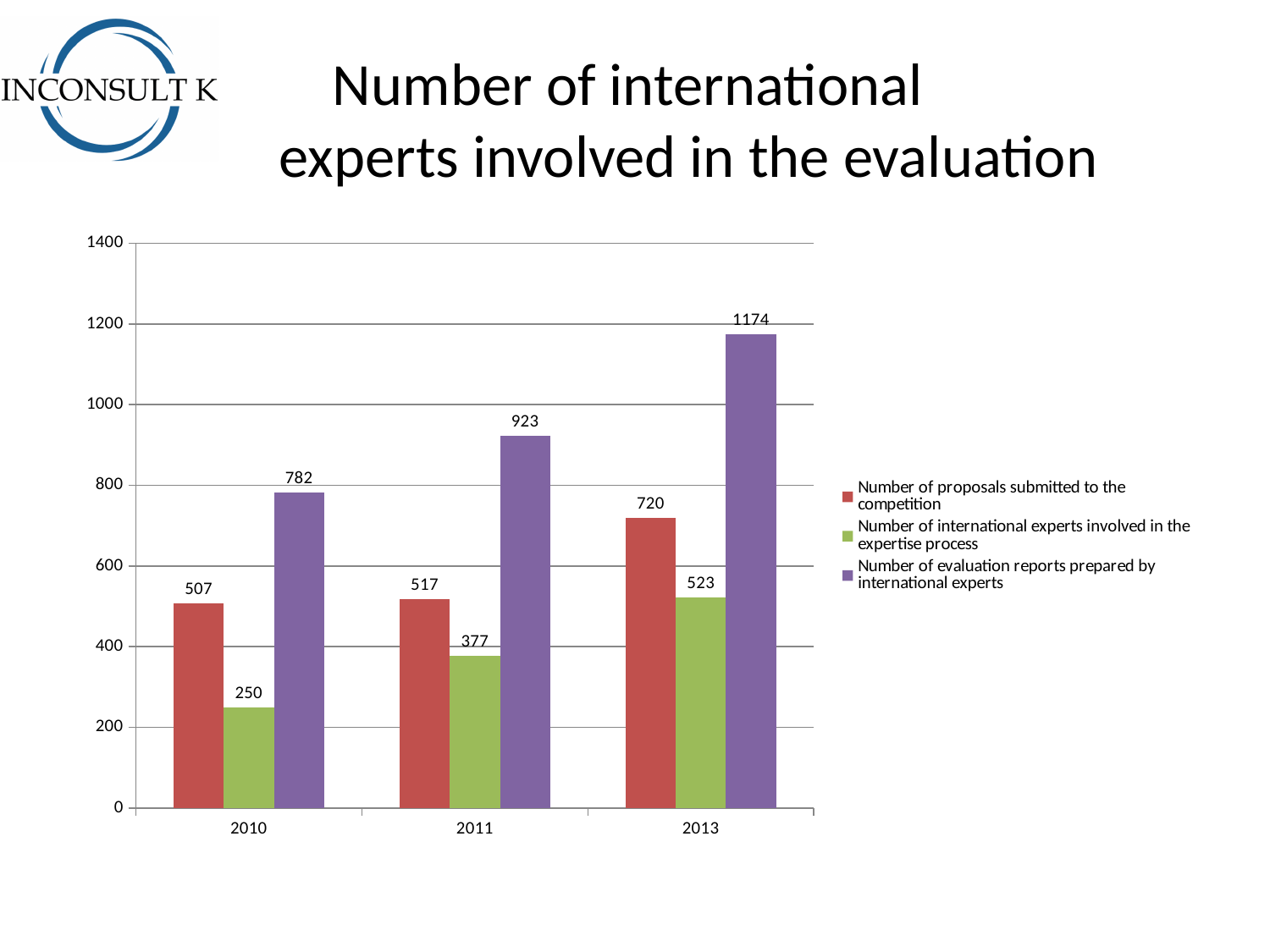
In which year is the number of international experts involved in the expertise process lowest? 2010 What is the number of international experts involved in the expertise process in 2011? 377 Does the number of proposals submitted to the competition rise or fall from 2010 to 2013? Rise How many years are shown on the x axis? 3 Is the number of evaluation reports prepared by international experts in 2010 greater or less than 600? greater What is the number of proposals submitted to the competition in 2010? 507 What is the difference between the number of evaluation reports prepared by international experts in 2013 and in 2011? 251 Which is larger in 2013: the number of proposals submitted to the competition or the number of international experts involved in the expertise process? Number of proposals submitted to the competition In which year is the number of evaluation reports prepared by international experts highest? 2013 What kind of chart is shown on the slide? Bar chart How many series does the legend list? 3 What is the number of evaluation reports prepared by international experts in 2013? 1174